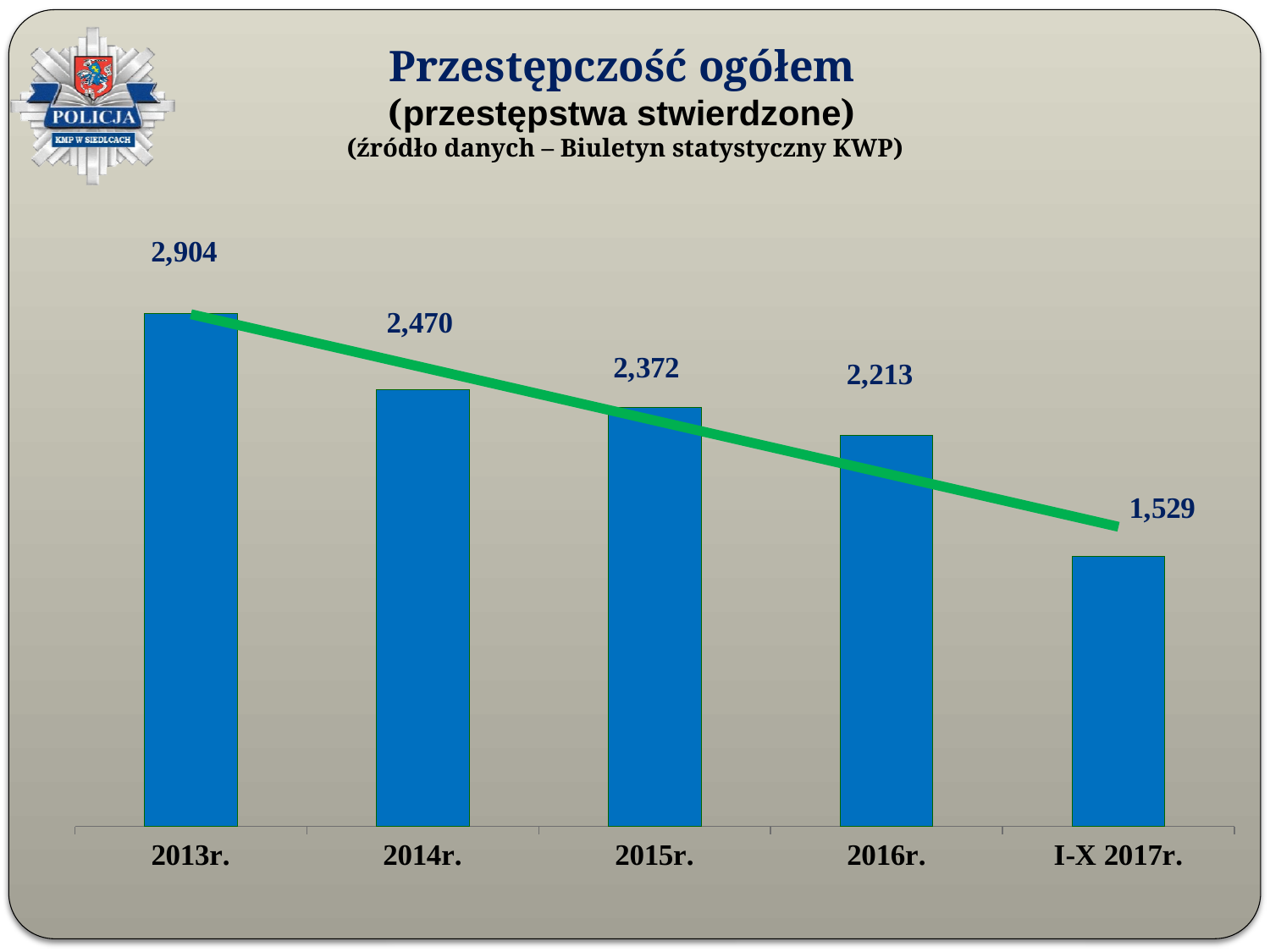
What is the title of the chart? Przestępczość ogółem (przestępstwa stwierdzone) Do the values rise or fall from 2013r. to I-X 2017r.? fall What is the difference between the values for 2016r. and I-X 2017r.? 684 What is the value for 2013r.? 2,904 Which category has the highest value? 2013r. Which is larger, the value for 2014r. or the value for 2016r.? 2014r. What is the difference between the values for 2013r. and 2014r.? 434 How many categories are shown on the x axis? 5 What is the value for 2015r.? 2,372 What is the value for I-X 2017r.? 1,529 What kind of chart is this? bar chart Which category has the lowest value? I-X 2017r.